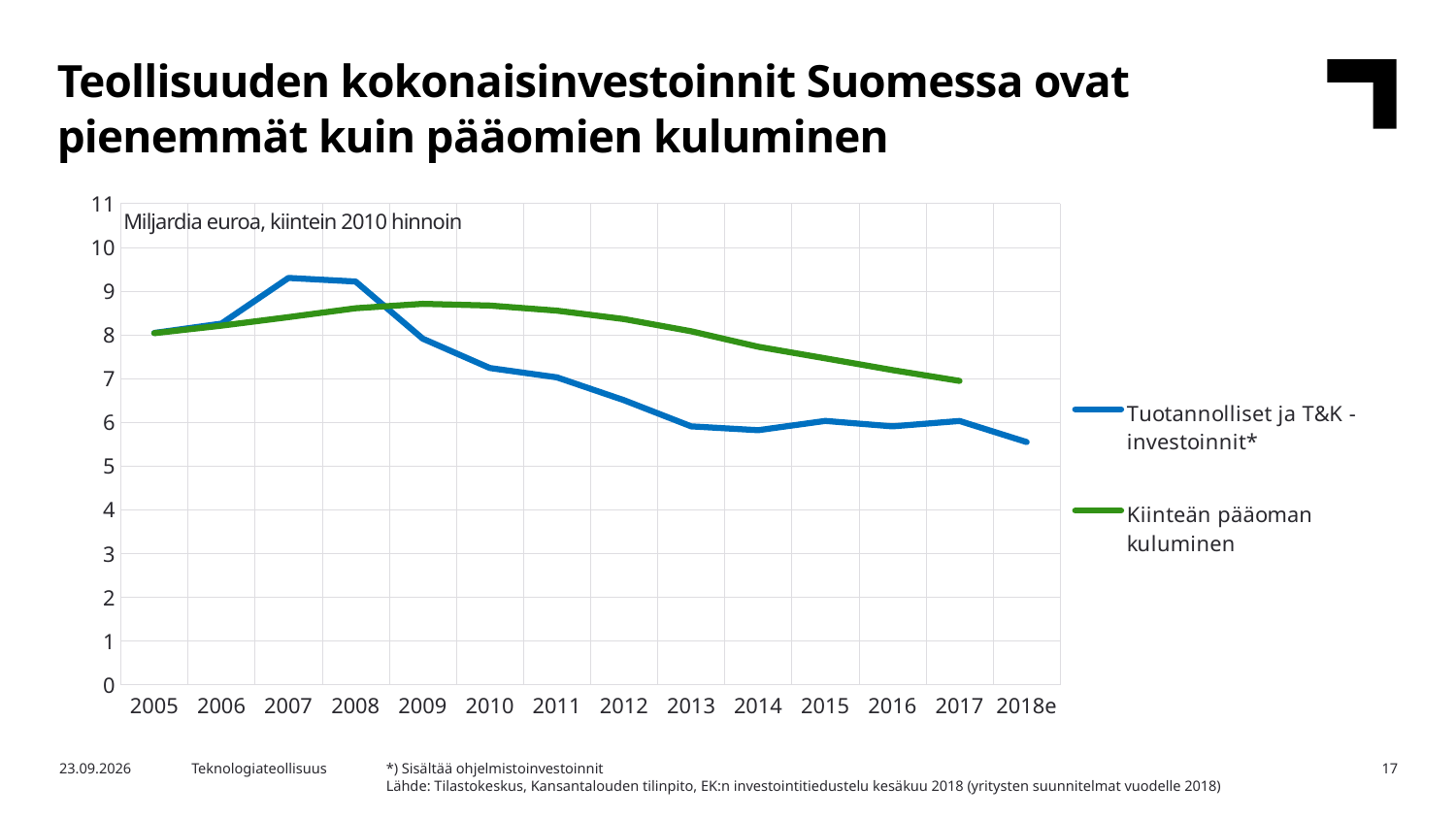
Is the value for Tuotannolliset ja T&K -investoinnit* in 2007 greater or less than 9? greater Is the value for Kiinteän pääoman kuluminen in 2017 greater or less than 8? less What kind of chart is shown on the slide? line chart Is the value for Kiinteän pääoman kuluminen in 2009 greater or less than 8? greater In 2012, which series has the higher value: Tuotannolliset ja T&K -investoinnit* or Kiinteän pääoman kuluminen? Kiinteän pääoman kuluminen What unit is stated inside the chart area? Miljardia euroa, kiintein 2010 hinnoin How many years are shown on the x axis? 14 In which year is Tuotannolliset ja T&K -investoinnit* at its lowest? 2018e In 2007, which series has the higher value: Tuotannolliset ja T&K -investoinnit* or Kiinteän pääoman kuluminen? Tuotannolliset ja T&K -investoinnit* How many series does the legend list? 2 Does Kiinteän pääoman kuluminen rise or fall from 2009 to 2017? fall